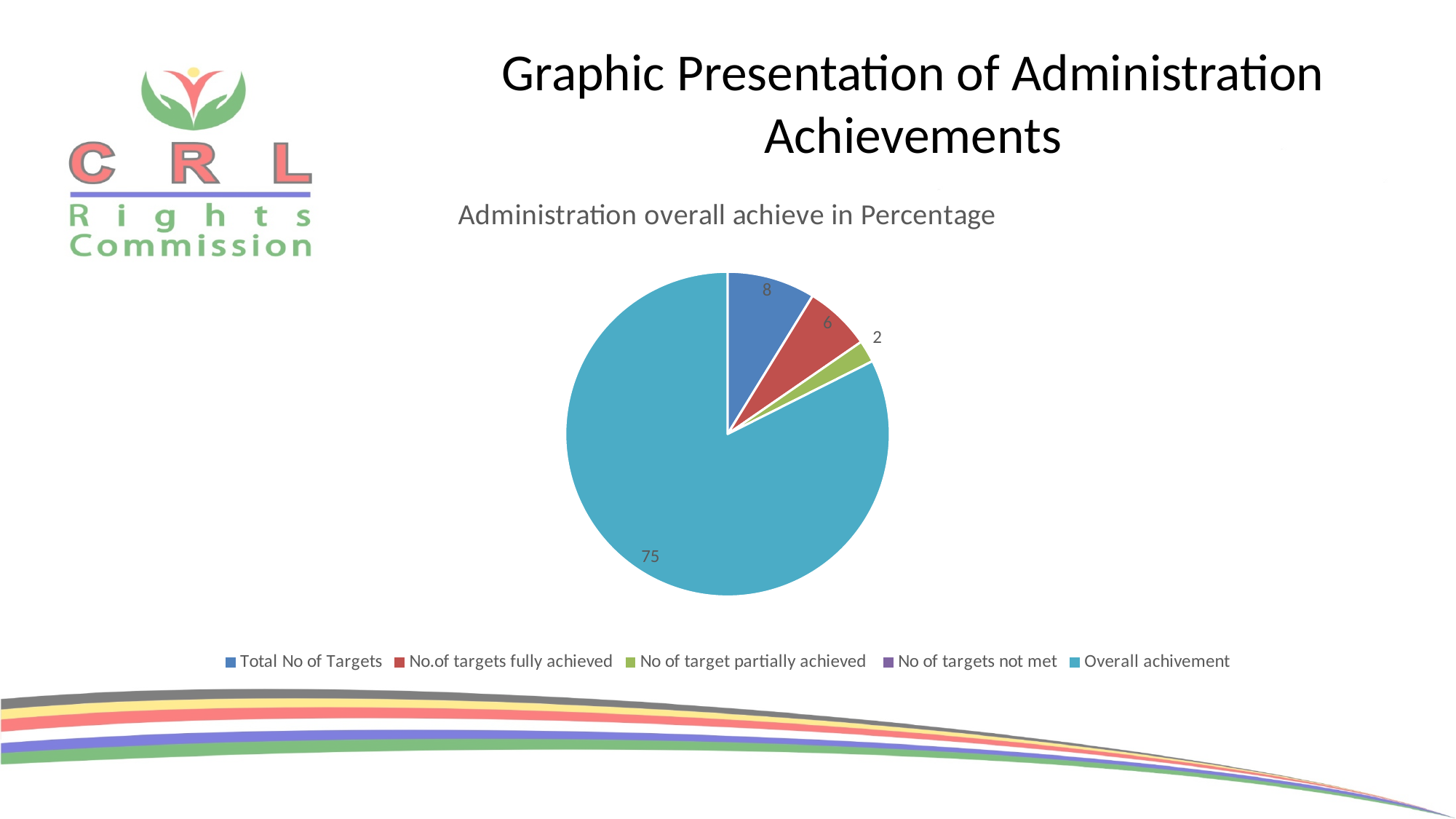
Which category has the largest slice of the pie? Overall achivement What colour is the slice for Overall achivement? teal How many categories does the legend list? 5 What is the value for No of target partially achieved? 2 Which is larger, the value for Total No of Targets or the value for No.of targets fully achieved? Total No of Targets What is the title of the chart? Administration overall achieve in Percentage What is the value for Total No of Targets? 8 Which of the labelled slices is the smallest? No of target partially achieved What is the value for Overall achivement? 75 What is the value for No.of targets fully achieved? 6 What is the difference between the values for Overall achivement and Total No of Targets? 67 What type of chart is shown on the slide? pie chart